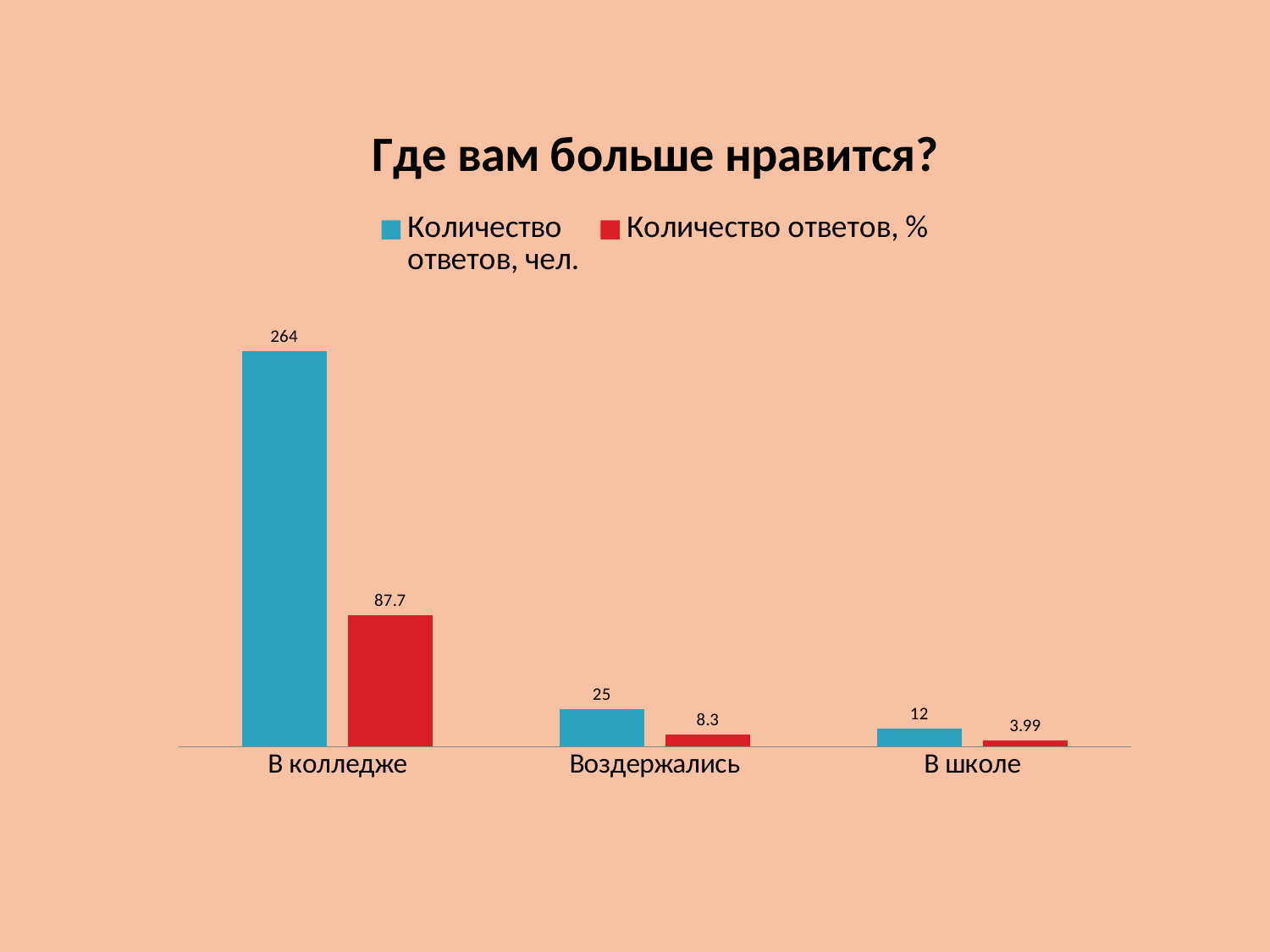
Which category has the lowest value for 'Количество ответов, %'? В школе What kind of chart is shown on the slide? Bar chart What is the value of 'Количество ответов, чел.' for 'В школе'? 12 What is the title of the chart? Где вам больше нравится? What is the value of 'Количество ответов, %' for 'Воздержались'? 8.3 What is the value of 'Количество ответов, %' for 'В школе'? 3.99 What is the value of 'Количество ответов, чел.' for 'В колледже'? 264 Which category has the highest value for 'Количество ответов, чел.'? В колледже How many series does the legend list? 2 Which is larger: 'Количество ответов, чел.' for 'Воздержались' or for 'В школе'? Воздержались What is the difference between the 'Количество ответов, чел.' values for 'В колледже' and 'Воздержались'? 239 How many categories are shown on the x axis? 3